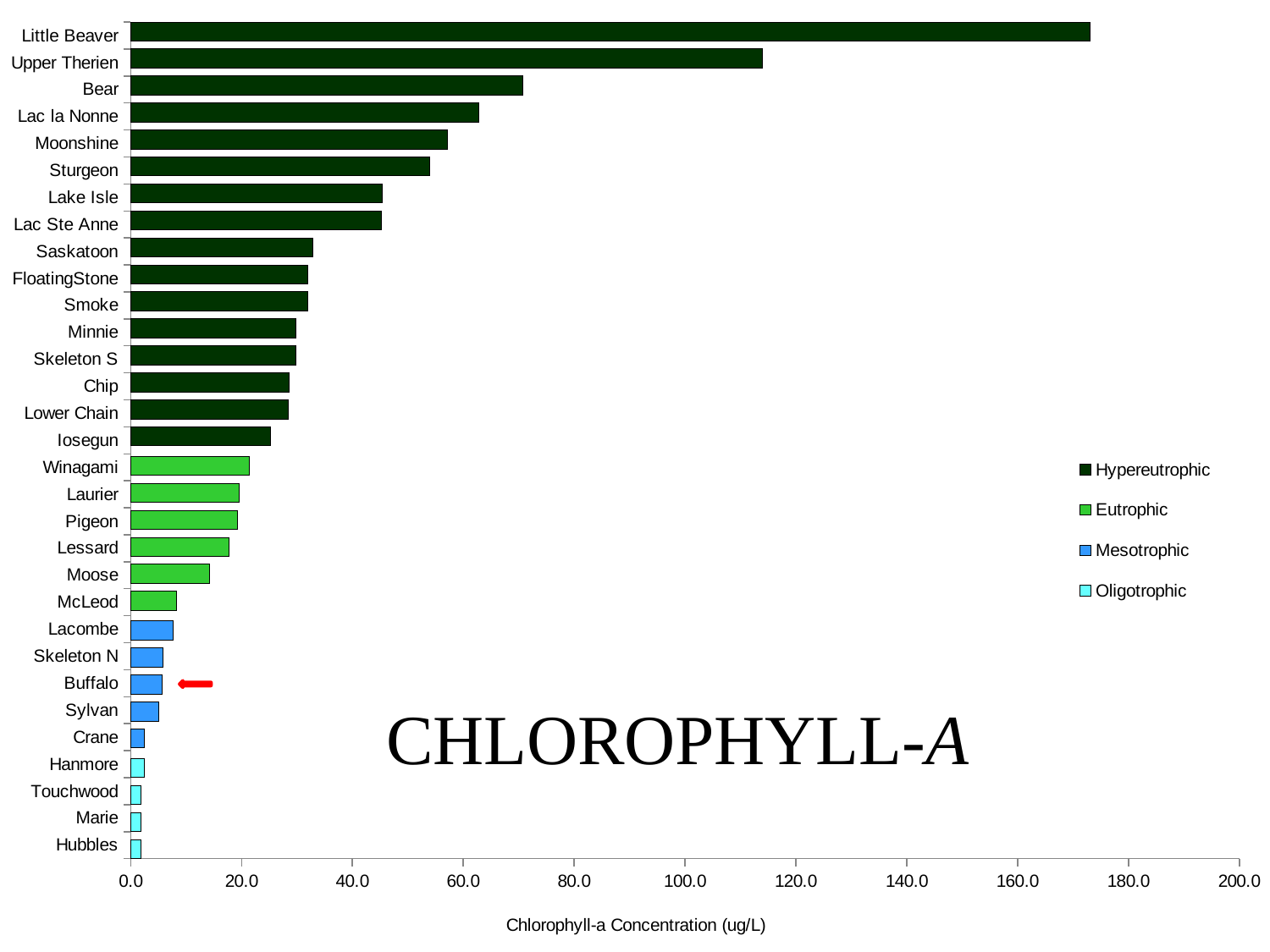
Which has the larger chlorophyll-a concentration, Bear or Sturgeon? Bear Is the value for Sturgeon greater or less than 60.0? less How many lakes (categories) are plotted on the chart? 31 Which lake's bar is marked with a red arrow? Buffalo What kind of chart is shown on the slide? bar chart Which lake has the highest chlorophyll-a concentration? Little Beaver Is the value for Moose greater or less than 20.0? less Is the value for Upper Therien greater or less than 100.0? greater How many entries does the legend list? 4 What is the label on the horizontal axis of the chart? Chlorophyll-a Concentration (ug/L) Which has the larger chlorophyll-a concentration, Upper Therien or Bear? Upper Therien